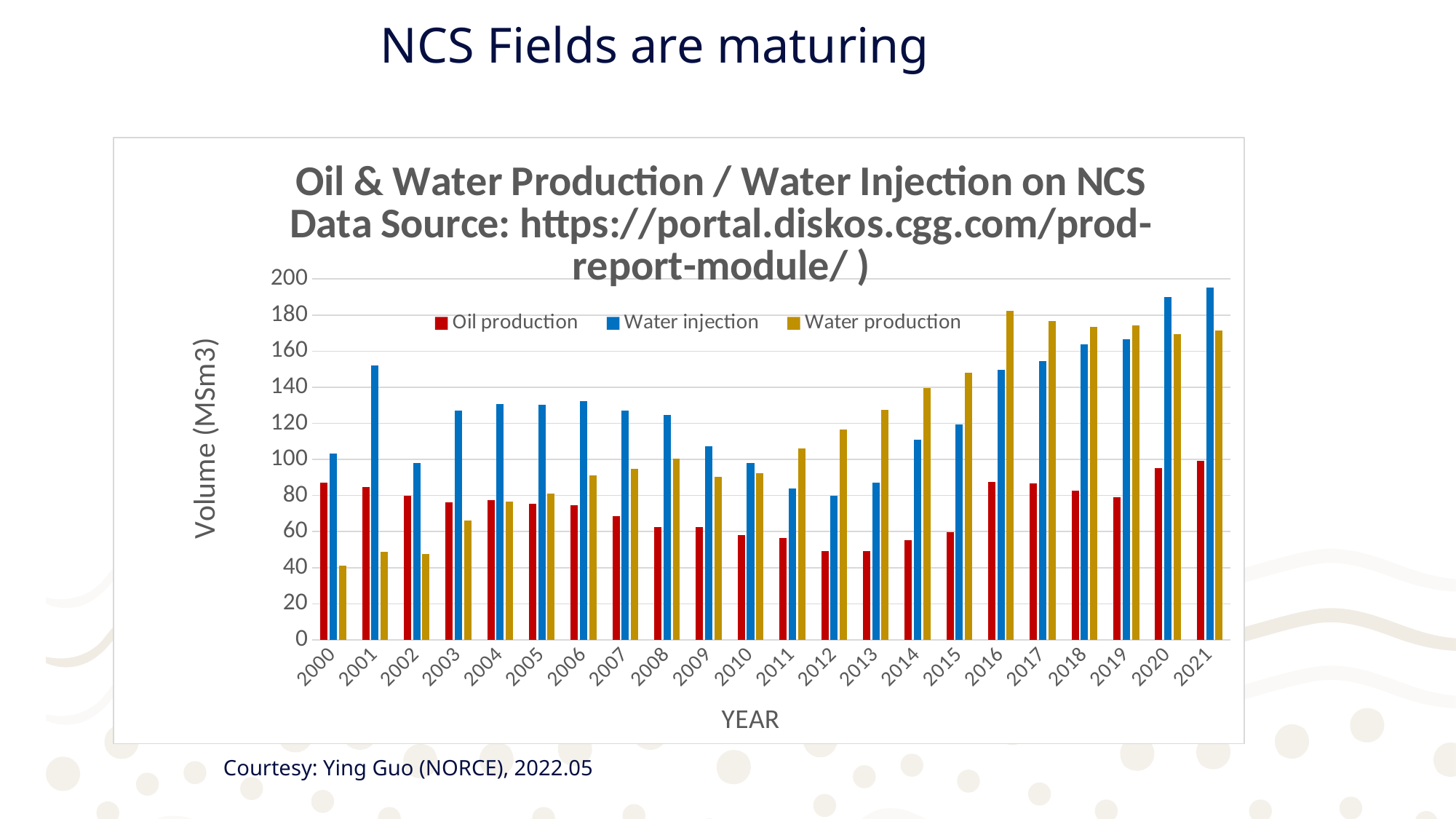
In which year is Water production lowest? 2000 Is the value for Water production in 2014 greater or less than 120? greater How many years are shown on the x axis? 22 Is the value for Oil production in 2012 greater or less than 60? less Does Water production generally rise or fall from 2000 to 2016? Rise In which year is Water production highest? 2016 How many series does the legend list? 3 Is the value for Water injection in 2001 greater or less than 140? greater In which year is Water injection highest? 2021 In 2000, which is larger: Oil production or Water production? Oil production In 2021, which is larger: Water injection or Oil production? Water injection What kind of chart is shown on the slide? Bar chart